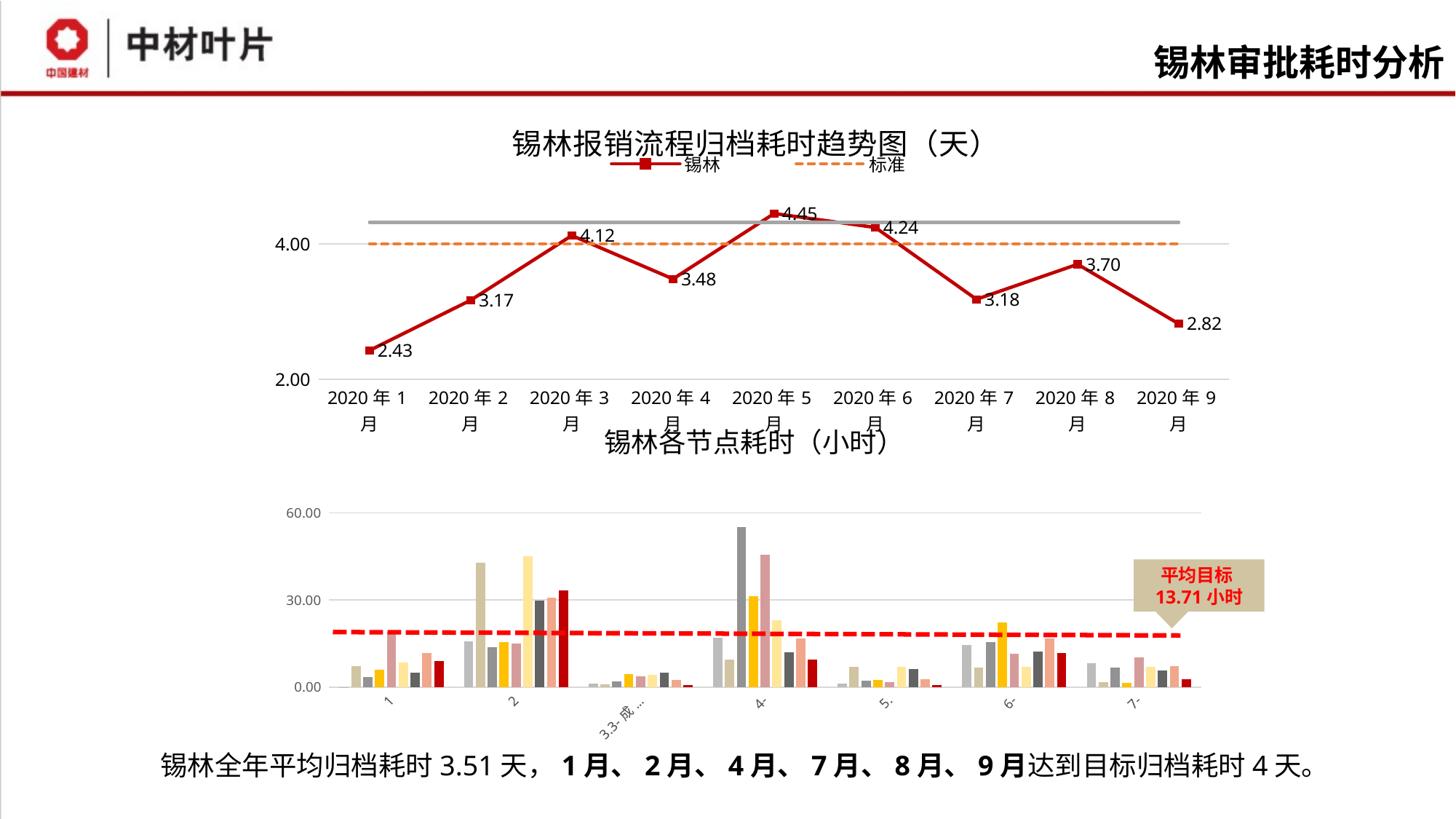
In the chart titled 锡林各节点耗时（小时）, what average target value is shown in the callout? 13.71 小时 In the chart titled 锡林报销流程归档耗时趋势图（天）, how many entries does the legend list? 2 In the chart titled 锡林报销流程归档耗时趋势图（天）, how many months are plotted on the x axis? 9 In the chart titled 锡林报销流程归档耗时趋势图（天）, which month has the highest value? 2020年5月 What kind of chart is the chart titled 锡林报销流程归档耗时趋势图（天）? line chart In the chart titled 锡林报销流程归档耗时趋势图（天）, what is the value for 2020年8月? 3.70 What kind of chart is the chart titled 锡林各节点耗时（小时）? bar chart In the chart titled 锡林报销流程归档耗时趋势图（天）, what is the value for 2020年5月? 4.45 In the chart titled 锡林报销流程归档耗时趋势图（天）, which month has the lowest value? 2020年1月 In the chart titled 锡林报销流程归档耗时趋势图（天）, what is the value for 2020年1月? 2.43 In the chart titled 锡林报销流程归档耗时趋势图（天）, which is larger, the value for 2020年3月 or 2020年4月? 2020年3月 In the chart titled 锡林报销流程归档耗时趋势图（天）, what is the difference between the values for 2020年5月 and 2020年9月? 1.63